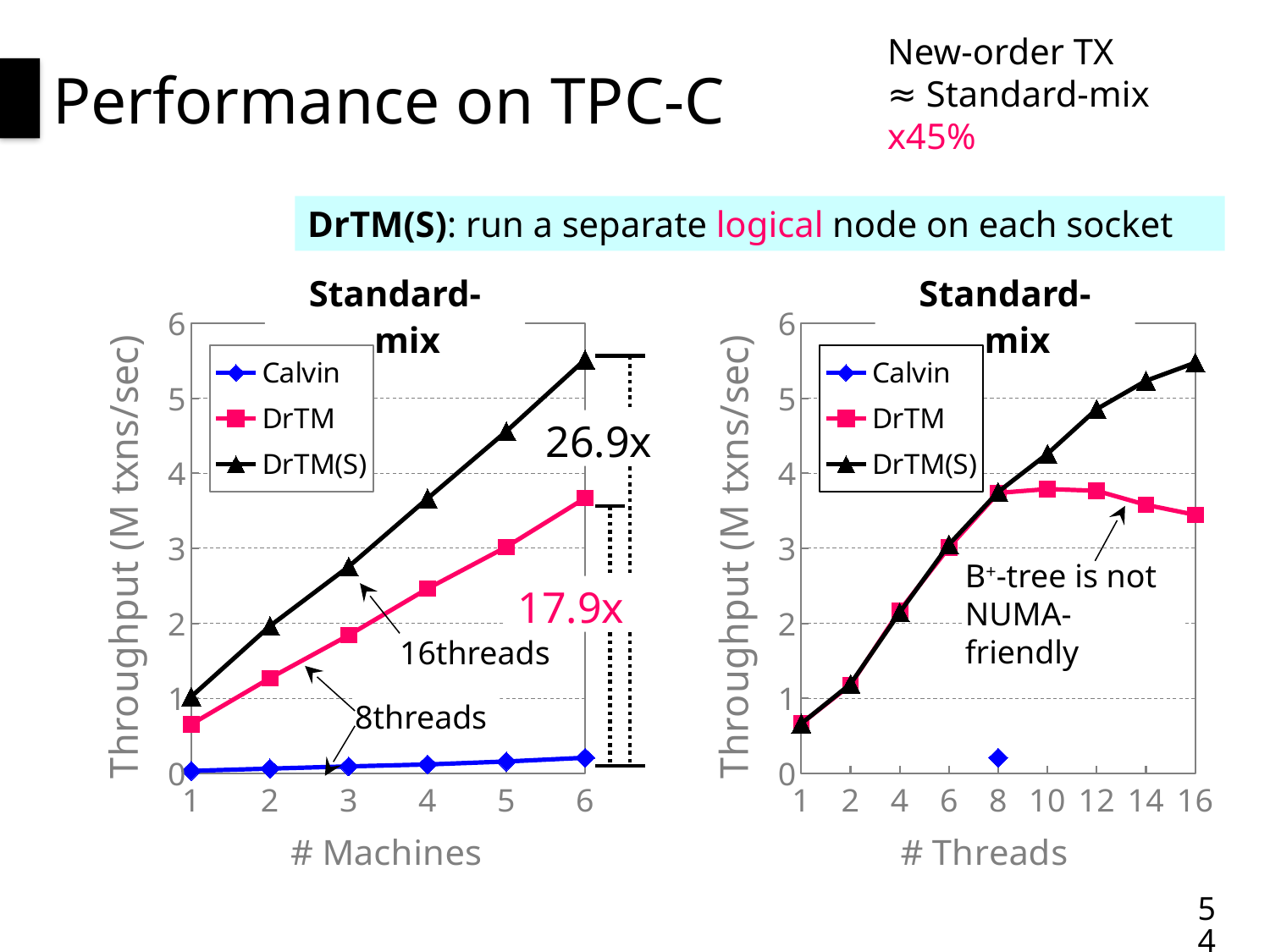
In the left chart (x axis # Machines), is the value for DrTM(S) at 6 machines greater or less than 5? greater In the right chart (x axis # Threads), which is larger at 16 threads, DrTM or DrTM(S)? DrTM(S) In the right chart (x axis # Threads), is the value for DrTM(S) at 16 threads greater or less than 5? greater In the right chart (x axis # Threads), is the value for DrTM at 16 threads greater or less than 4? less How many series does the legend of the left chart (x axis # Machines) list? 3 In the left chart (x axis # Machines), which series has the highest throughput at 6 machines? DrTM(S) What is the x-axis label of the right chart? # Threads How many x-axis points (thread counts) are shown in the right chart (x axis # Threads)? 9 In the left chart (x axis # Machines), does the DrTM throughput rise or fall as the number of machines increases? rise In the left chart (x axis # Machines), which series has the lowest throughput at 6 machines? Calvin What kind of chart is the left chart (x axis # Machines)? line chart